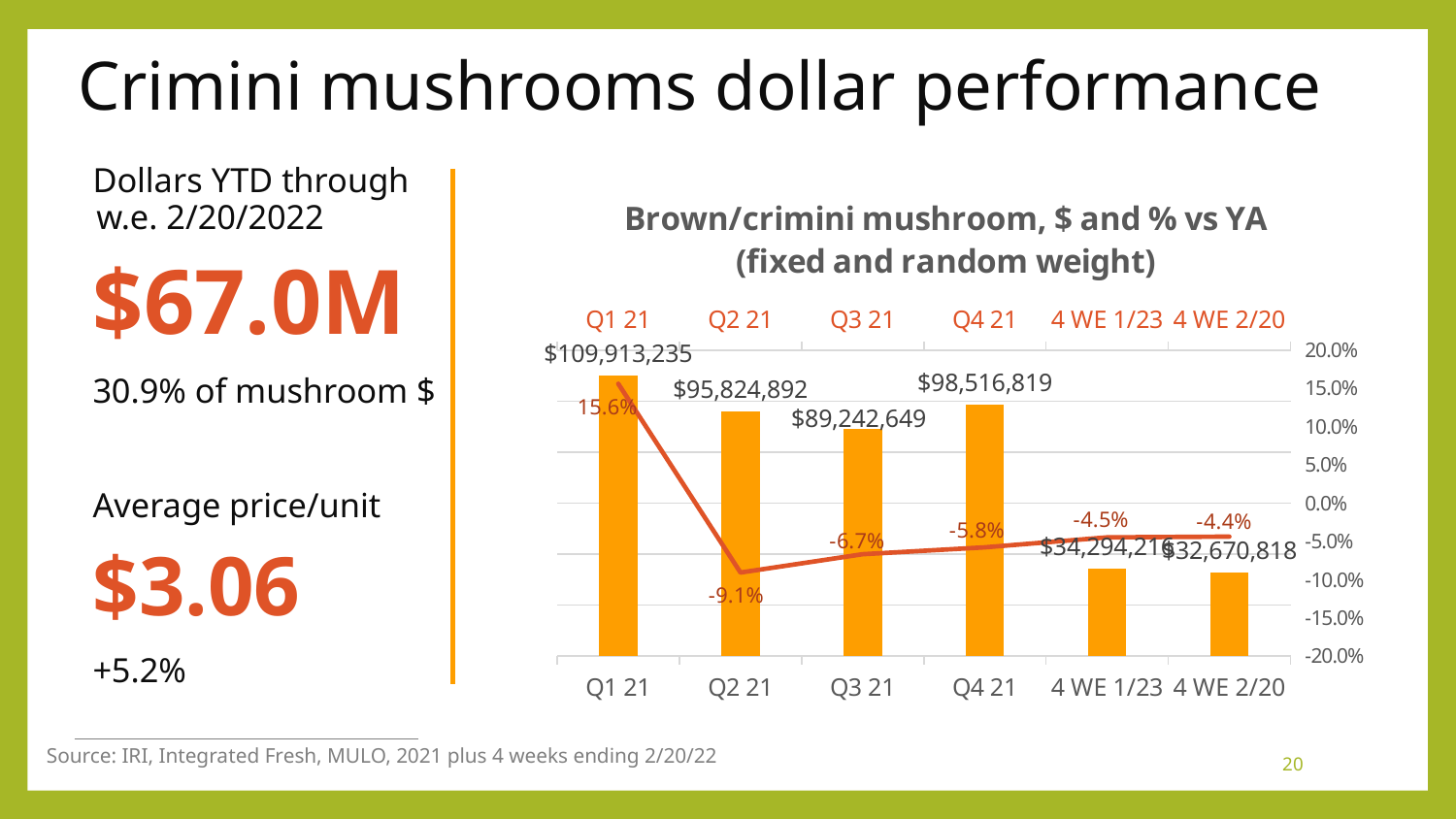
Which has the larger dollar value in the Brown/crimini mushroom chart, Q3 21 or Q4 21? Q4 21 How many periods are shown on the x axis of the Brown/crimini mushroom chart? 6 Does the % vs YA line rise or fall from Q2 21 to 4 WE 2/20 in the Brown/crimini mushroom chart? Rise What is the dollar value for 4 WE 2/20 in the Brown/crimini mushroom chart? $32,670,818 What is the difference in dollars between Q1 21 and Q2 21 in the Brown/crimini mushroom chart? $14,088,343 What is the dollar value for Q1 21 in the Brown/crimini mushroom chart? $109,913,235 What kind of chart is the Brown/crimini mushroom chart? Bar chart with a line Which period has the highest dollar bar in the Brown/crimini mushroom chart? Q1 21 What is the % vs YA value for Q2 21 in the Brown/crimini mushroom chart? -9.1% What is the dollar value for Q3 21 in the Brown/crimini mushroom chart? $89,242,649 Which period has the lowest % vs YA value in the Brown/crimini mushroom chart? Q2 21 What is the % vs YA value for 4 WE 2/20 in the Brown/crimini mushroom chart? -4.4%